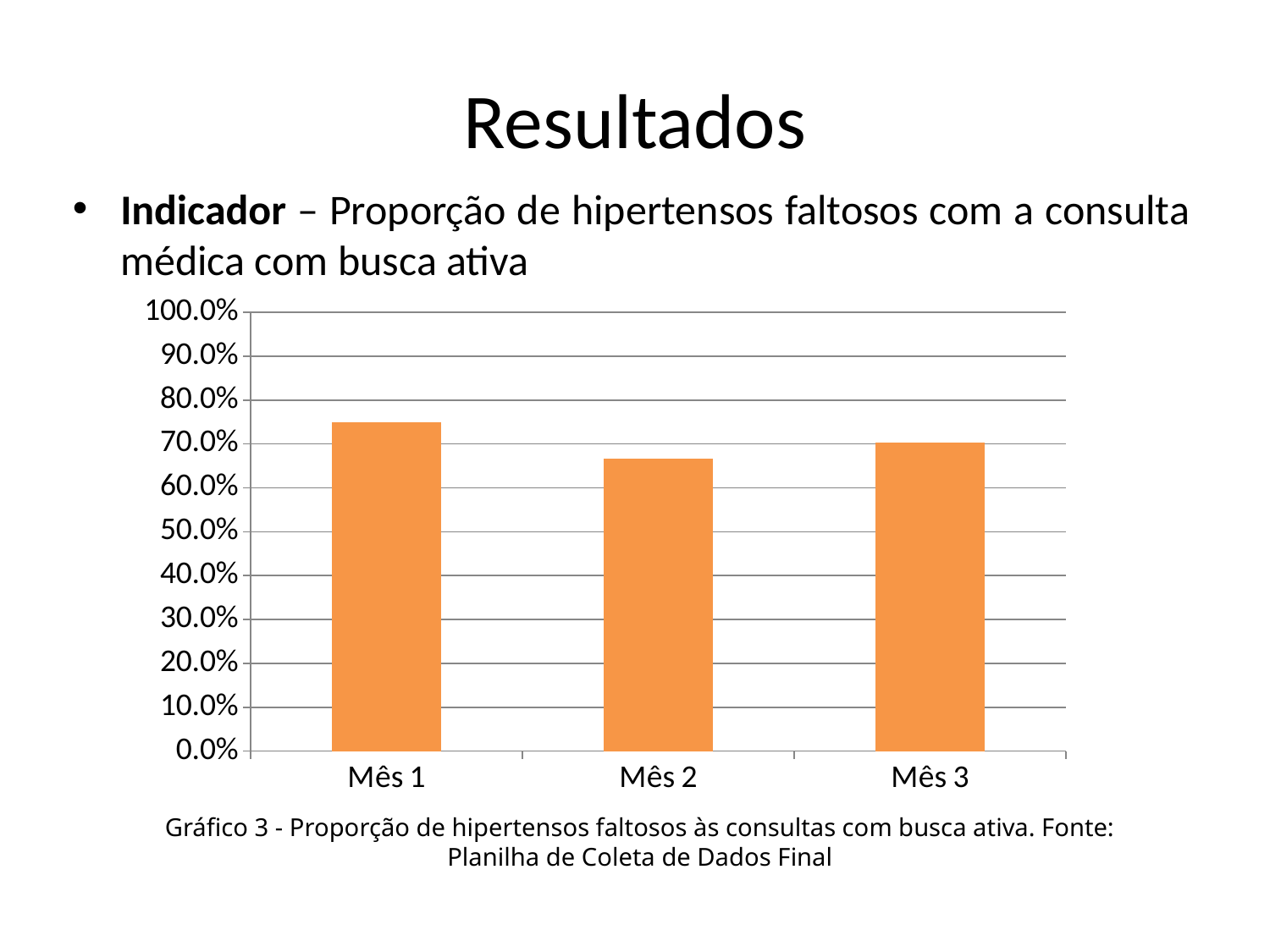
What colour are the bars in the chart? orange Is the value for Mês 3 greater or less than 80.0%? less Which month has the lowest proportion in the chart? Mês 2 What kind of chart is shown on the slide? bar chart What is the maximum value shown on the y axis of the chart? 100.0% Which month has the highest proportion in the chart? Mês 1 How many categories (months) are shown on the x axis of the chart? 3 Is the value for Mês 2 greater or less than 60.0%? greater Which is larger, the value for Mês 2 or the value for Mês 3? Mês 3 Is the value for Mês 2 greater or less than 70.0%? less Which is larger, the value for Mês 1 or the value for Mês 3? Mês 1